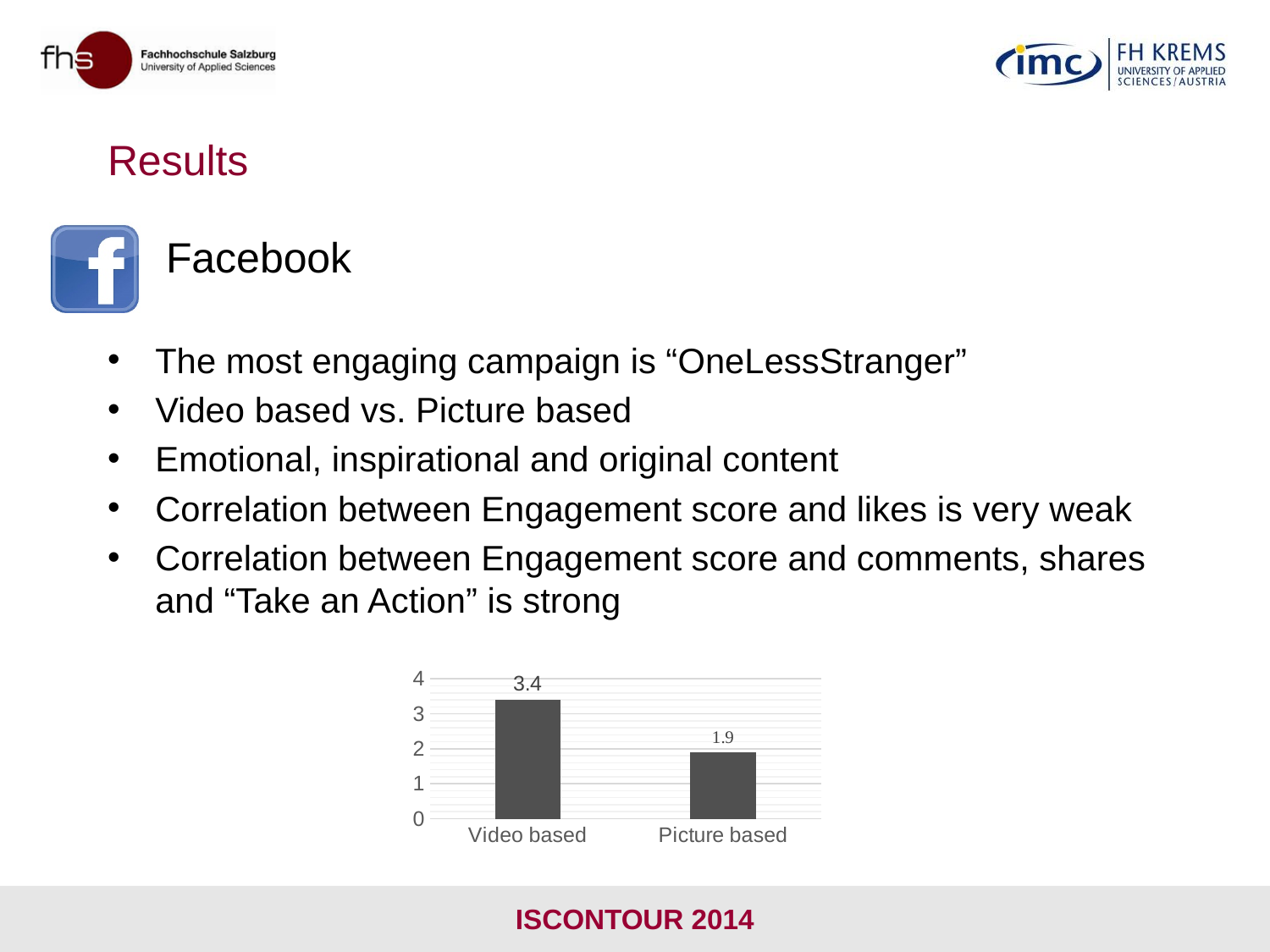
Which category has the lowest value? Picture based What is the value for Picture based? 1.9 Is the value for Video based greater or less than 3? greater What is the highest value shown on the vertical axis? 4 What is the value for Video based? 3.4 What is the label of the first category on the x axis? Video based Which is larger, the value for Video based or the value for Picture based? Video based Is the value for Picture based greater or less than 2? less Which category has the highest value? Video based How many categories are shown in the chart? 2 What kind of chart is shown on the slide? bar chart What is the difference between the values for Video based and Picture based? 1.5